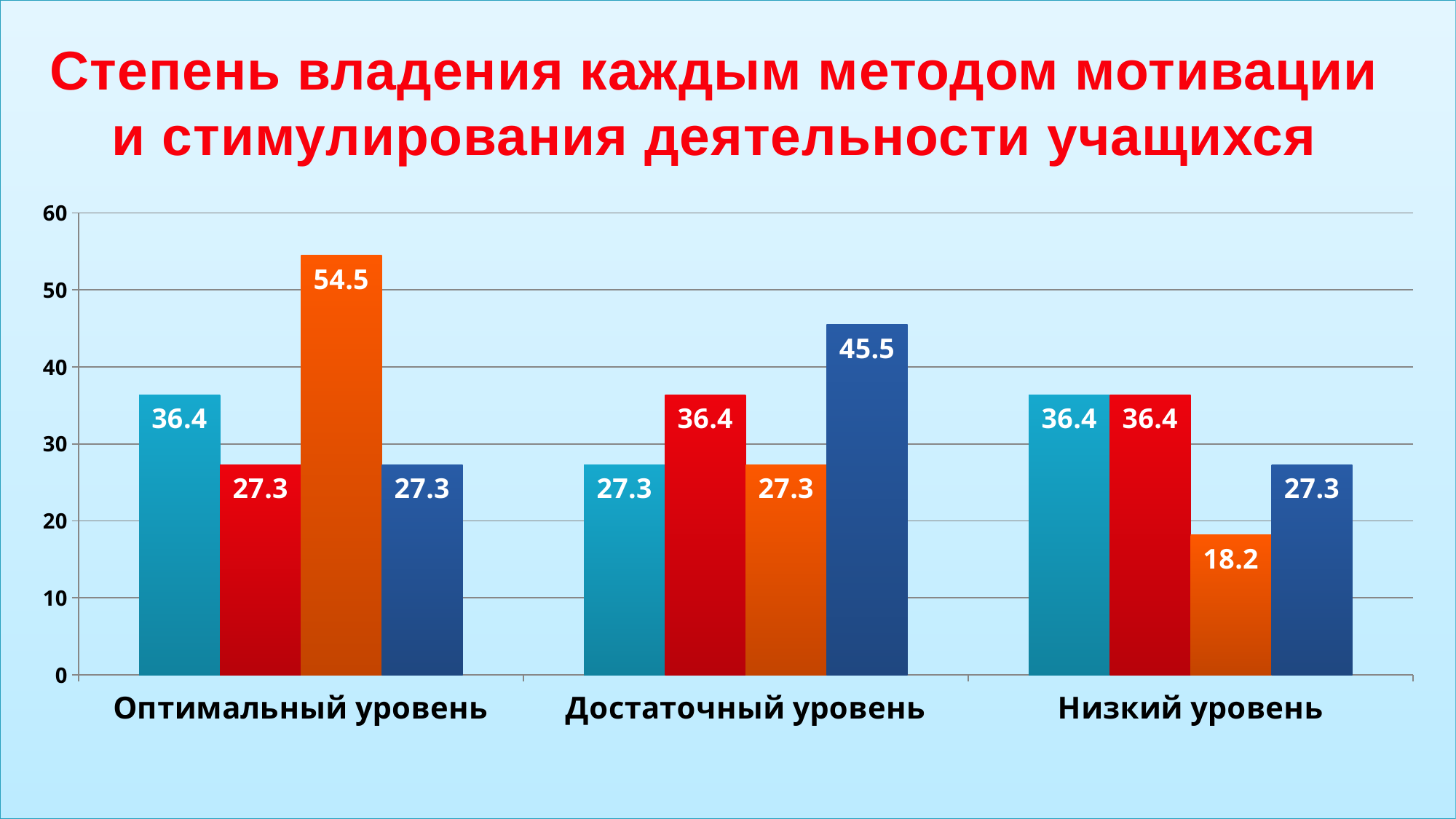
Which category has the lowest orange bar? Низкий уровень What is the difference between the orange bar for Оптимальный уровень and the orange bar for Низкий уровень? 36.3 How many categories are shown on the x axis? 3 What is the title of the chart on the slide? Степень владения каждым методом мотивации и стимулирования деятельности учащихся Which is larger: the dark blue bar for Достаточный уровень or the dark blue bar for Низкий уровень? Достаточный уровень Which category has the highest orange bar? Оптимальный уровень How many bars are plotted for each category? 4 What is the value of the light blue bar for Достаточный уровень? 27.3 What is the value of the orange bar for Оптимальный уровень? 54.5 What is the value of the orange bar for Низкий уровень? 18.2 What type of chart is shown on the slide? bar chart What is the value of the dark blue bar for Достаточный уровень? 45.5